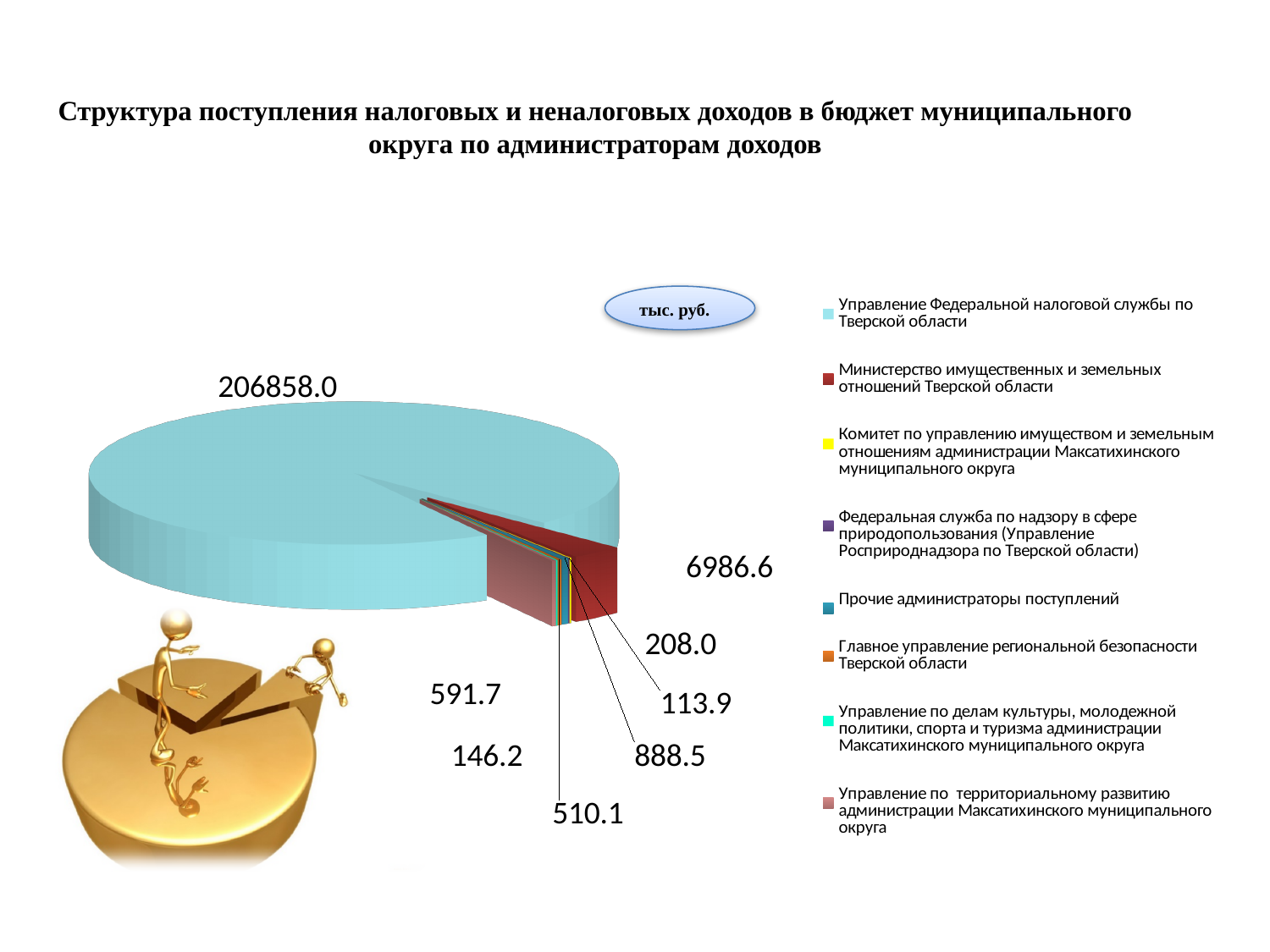
What is the value for Министерство имущественных и земельных отношений Тверской области? 6986.6 Which is larger: the value for Управление Федеральной налоговой службы по Тверской области or the value for Министерство имущественных и земельных отношений Тверской области? Управление Федеральной налоговой службы по Тверской области What is the value for Управление Федеральной налоговой службы по Тверской области? 206858.0 What is the difference between the value for Управление Федеральной налоговой службы по Тверской области and the value for Министерство имущественных и земельных отношений Тверской области? 199871.4 What colour is the largest slice of the pie chart? Light blue What kind of chart is shown on the slide? Pie chart In what unit are the values on the chart given, according to the label on the slide? тыс. руб. Which administrator has the largest share of the pie chart? Управление Федеральной налоговой службы по Тверской области What is the smallest value labelled on the pie chart? 113.9 How many slices (data labels) does the pie chart have? 8 How many entries does the legend of the pie chart list? 8